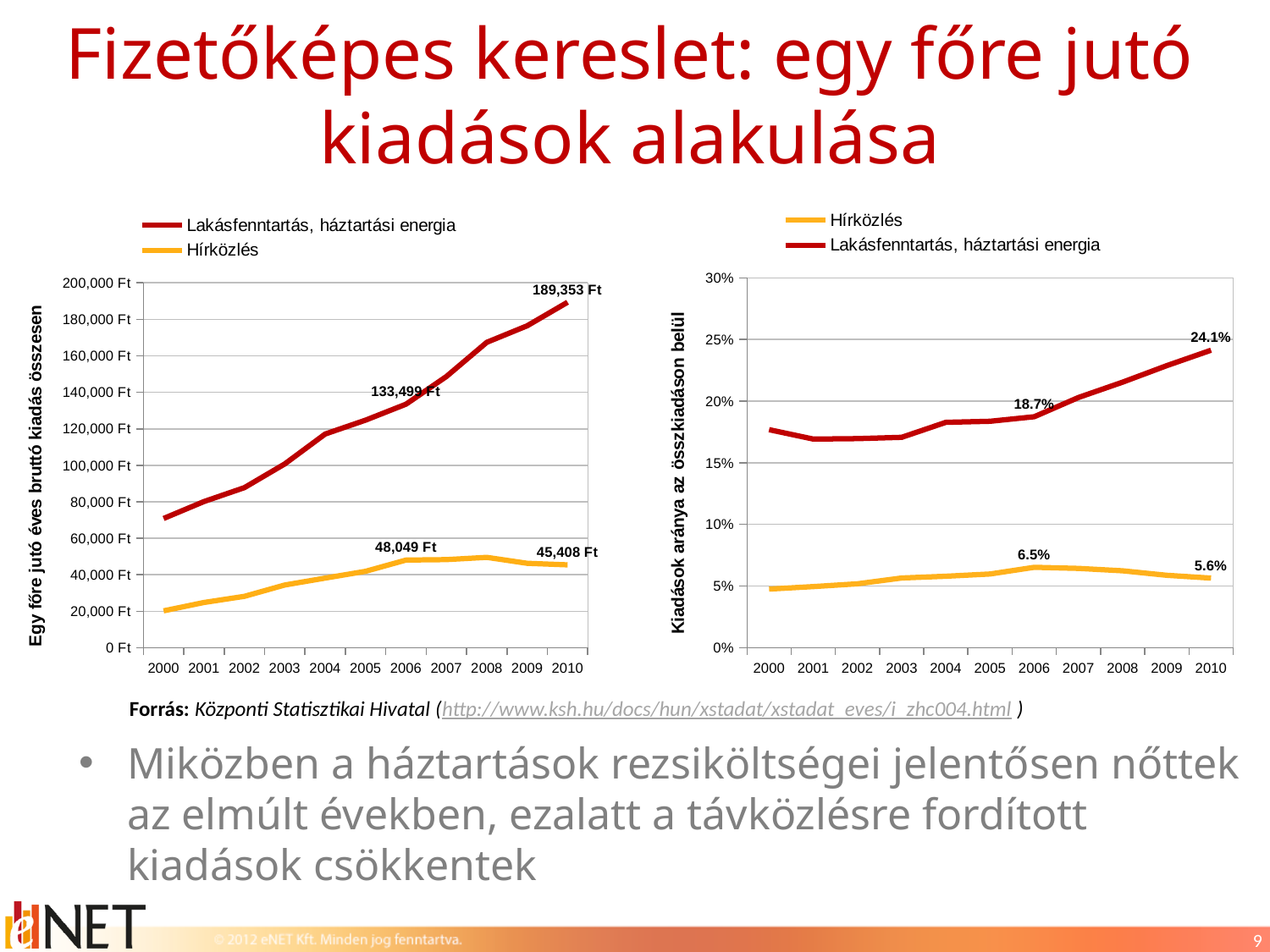
In the right chart, by how many percentage points did the Hírközlés share fall from 2006 to 2010? 0.9 percentage points In the left chart, what is the difference between the 2010 values of Lakásfenntartás, háztartási energia and Hírközlés? 143,945 Ft In the right chart, what share does Lakásfenntartás, háztartási energia have in 2010? 24.1% How many series does the legend of the right chart list? 2 In the left chart, does the Lakásfenntartás, háztartási energia line rise or fall from 2000 to 2010? Rises How many years are shown on the x axis of the left chart? 11 In the left chart, what is the value for Hírközlés in 2006? 48,049 Ft What kind of chart is the left chart? Line chart In the right chart, what share does Hírközlés have in 2010? 5.6% In the right chart, which series has the larger share in 2006, Lakásfenntartás, háztartási energia or Hírközlés? Lakásfenntartás, háztartási energia In the left chart, is the value for Lakásfenntartás, háztartási energia in 2000 greater or less than 80,000 Ft? less In the left chart, what is the value for Lakásfenntartás, háztartási energia in 2010? 189,353 Ft